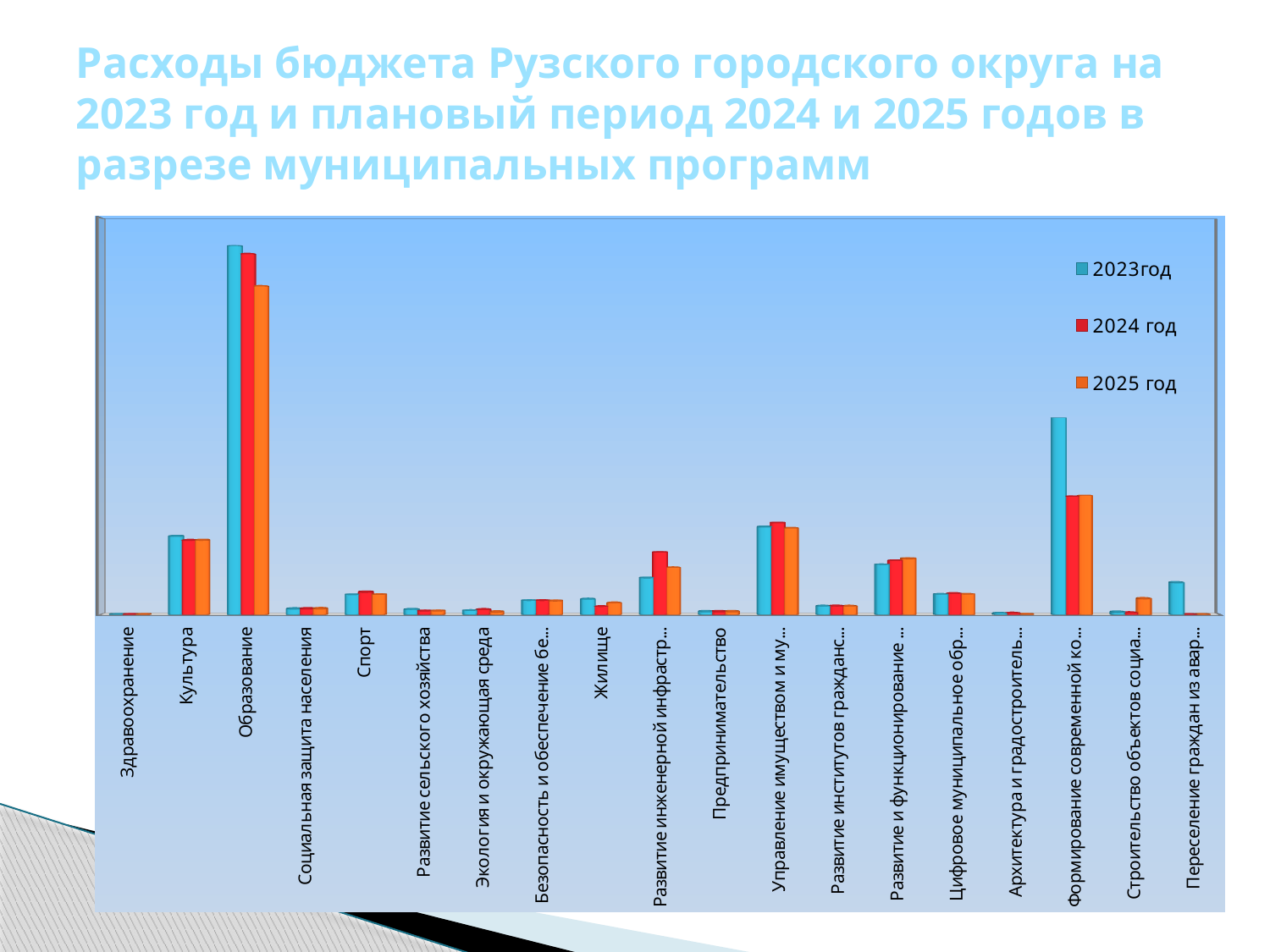
Which series is shown in red? 2024 год For Формирование современной ко..., is the 2023год value larger or smaller than the 2024 год value? larger Which category has the highest value for 2023год? Образование What kind of chart is shown on the slide? bar chart Which year has the highest value for Развитие инженерной инфрастр...? 2024 год Which category has the second-highest value for 2023год? Формирование современной ко... Which is larger for 2023год: Культура or Спорт? Культура For Образование, do the values rise or fall from 2023год to 2025 год? fall Which series is shown in orange? 2025 год How many series does the legend list? 3 How many categories (municipal programmes) are shown on the x axis? 19